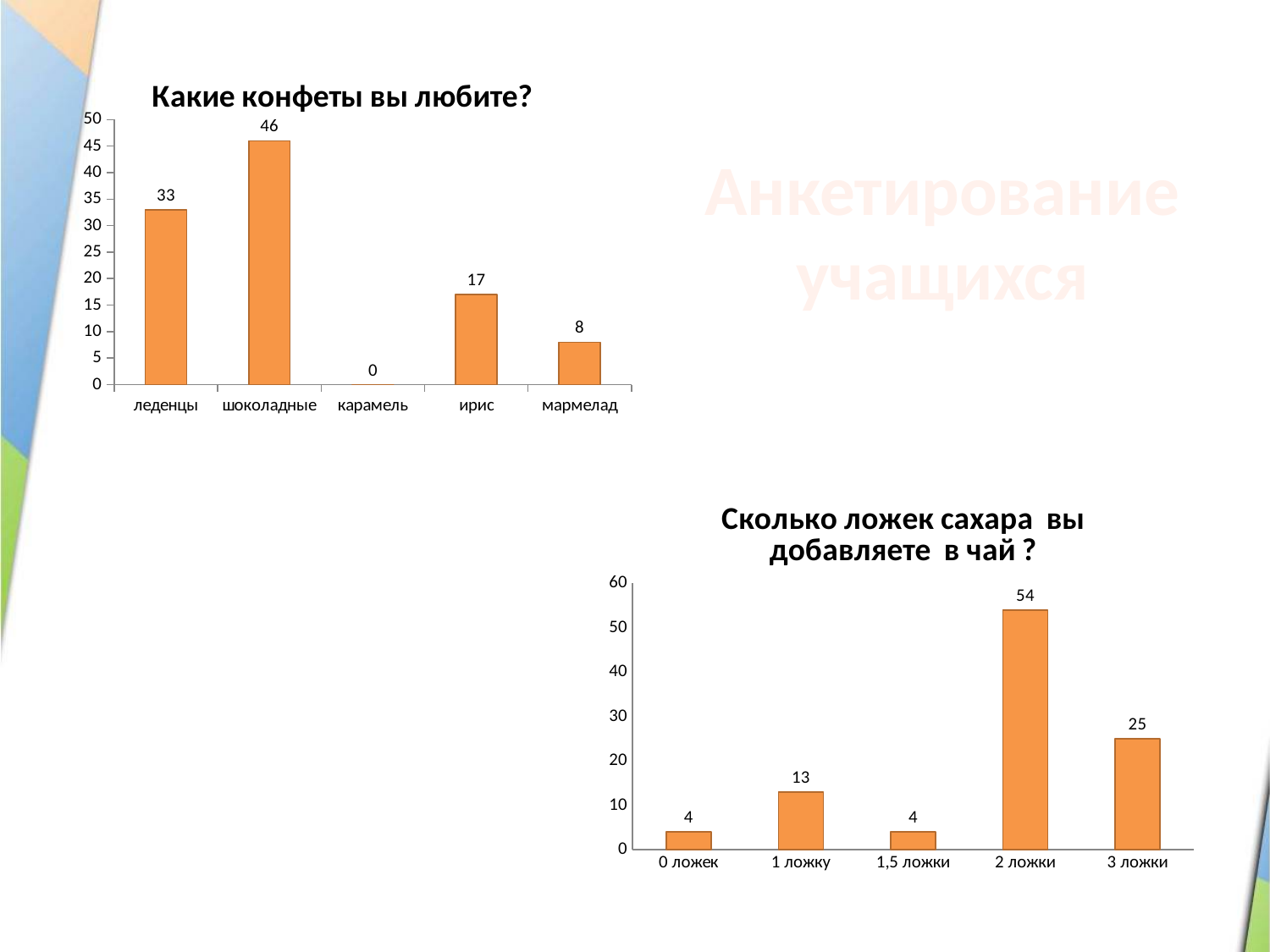
In the chart "Какие конфеты вы любите?", which category has the lowest value? карамель In the chart "Сколько ложек сахара вы добавляете в чай ?", what is the value for 1 ложку? 13 In the chart "Сколько ложек сахара вы добавляете в чай ?", which is larger, the value for 1 ложку or the value for 3 ложки? 3 ложки In the chart "Какие конфеты вы любите?", what is the value for мармелад? 8 In the chart "Какие конфеты вы любите?", which category has the highest value? шоколадные In the chart "Какие конфеты вы любите?", what is the difference between the values for леденцы and ирис? 16 In the chart "Сколько ложек сахара вы добавляете в чай ?", what is the value for 2 ложки? 54 In the chart "Сколько ложек сахара вы добавляете в чай ?", which category has the highest value? 2 ложки In the chart "Какие конфеты вы любите?", how many categories are shown on the x axis? 5 In the chart "Какие конфеты вы любите?", what is the value for шоколадные? 46 What kind of chart is "Сколько ложек сахара вы добавляете в чай ?"? bar chart In the chart "Сколько ложек сахара вы добавляете в чай ?", what is the difference between the values for 2 ложки and 3 ложки? 29